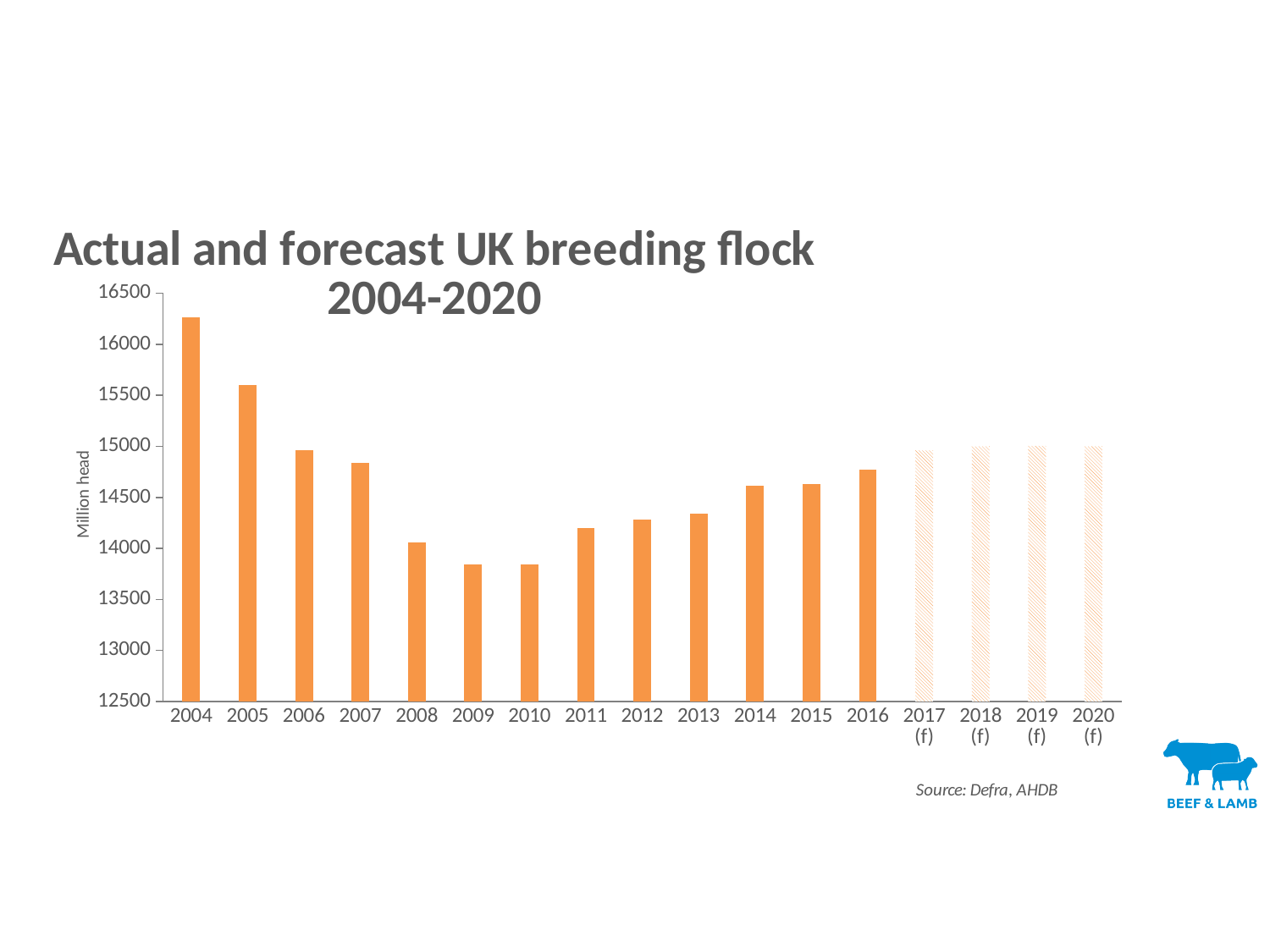
Is the value for 2016 greater or less than 14500? greater Is the value for 2007 greater or less than 15000? less Do the values rise or fall from 2010 to 2016? rise What is the label on the y axis? Million head Is the value for 2013 greater or less than 14500? less What kind of chart is shown on the slide? Bar chart Which is larger, the value for 2005 or the value for 2006? 2005 Which year has the highest breeding flock value? 2004 Do the values rise or fall from 2004 to 2010? fall How many years (categories) are shown on the x axis? 17